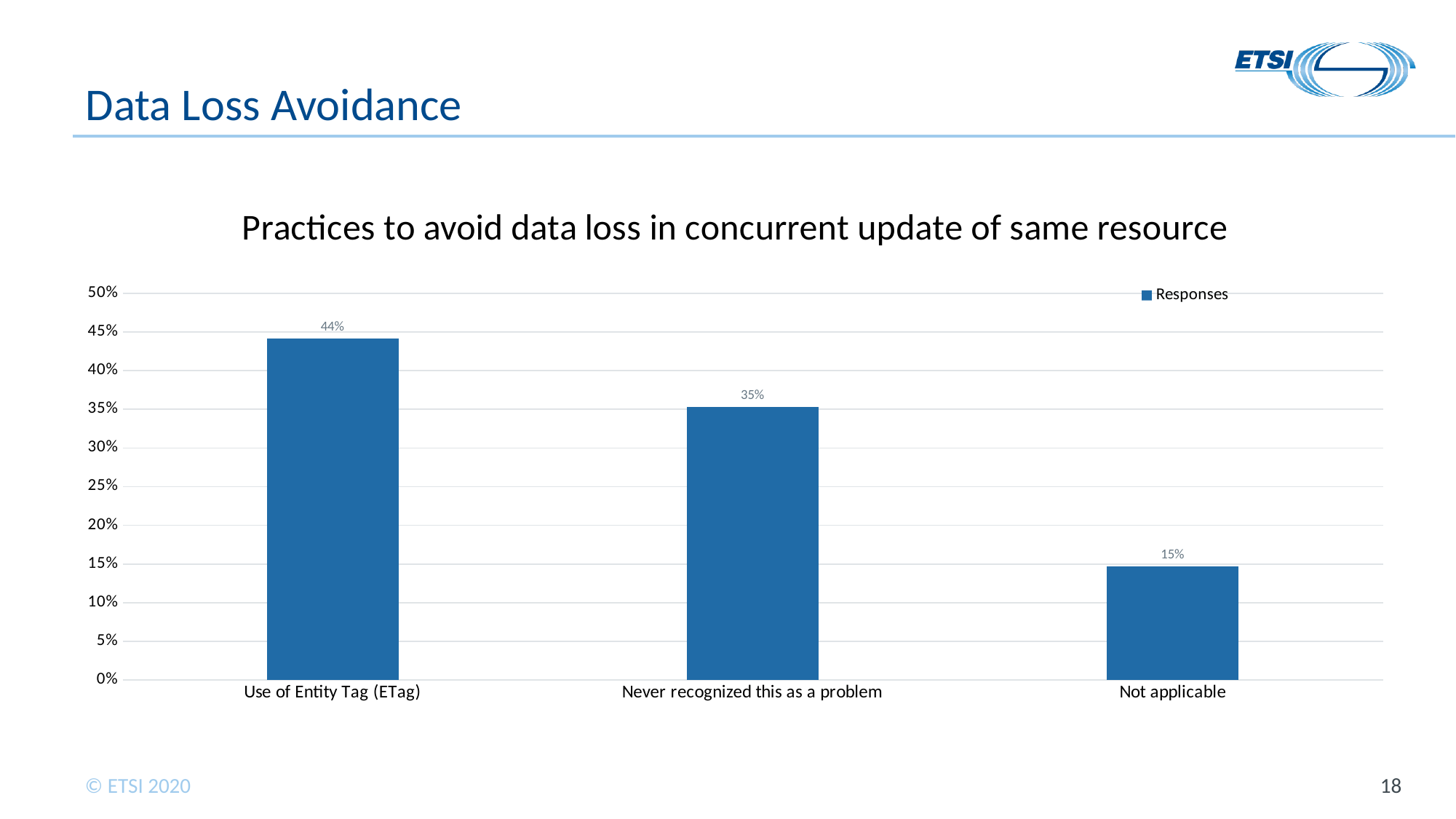
What is the value for Use of Entity Tag (ETag)? 44% What is the value for Never recognized this as a problem? 35% What is the difference between the values for Never recognized this as a problem and Not applicable? 20% Which category has the lowest value? Not applicable What is the value for Not applicable? 15% How many categories are shown on the x axis? 3 What is the title of the chart? Practices to avoid data loss in concurrent update of same resource Is the value for Never recognized this as a problem greater or less than 30%? greater What kind of chart is shown on the slide? bar chart What is the difference between the values for Use of Entity Tag (ETag) and Never recognized this as a problem? 9% Which category has the highest value? Use of Entity Tag (ETag) Which is larger, the value for Never recognized this as a problem or the value for Not applicable? Never recognized this as a problem